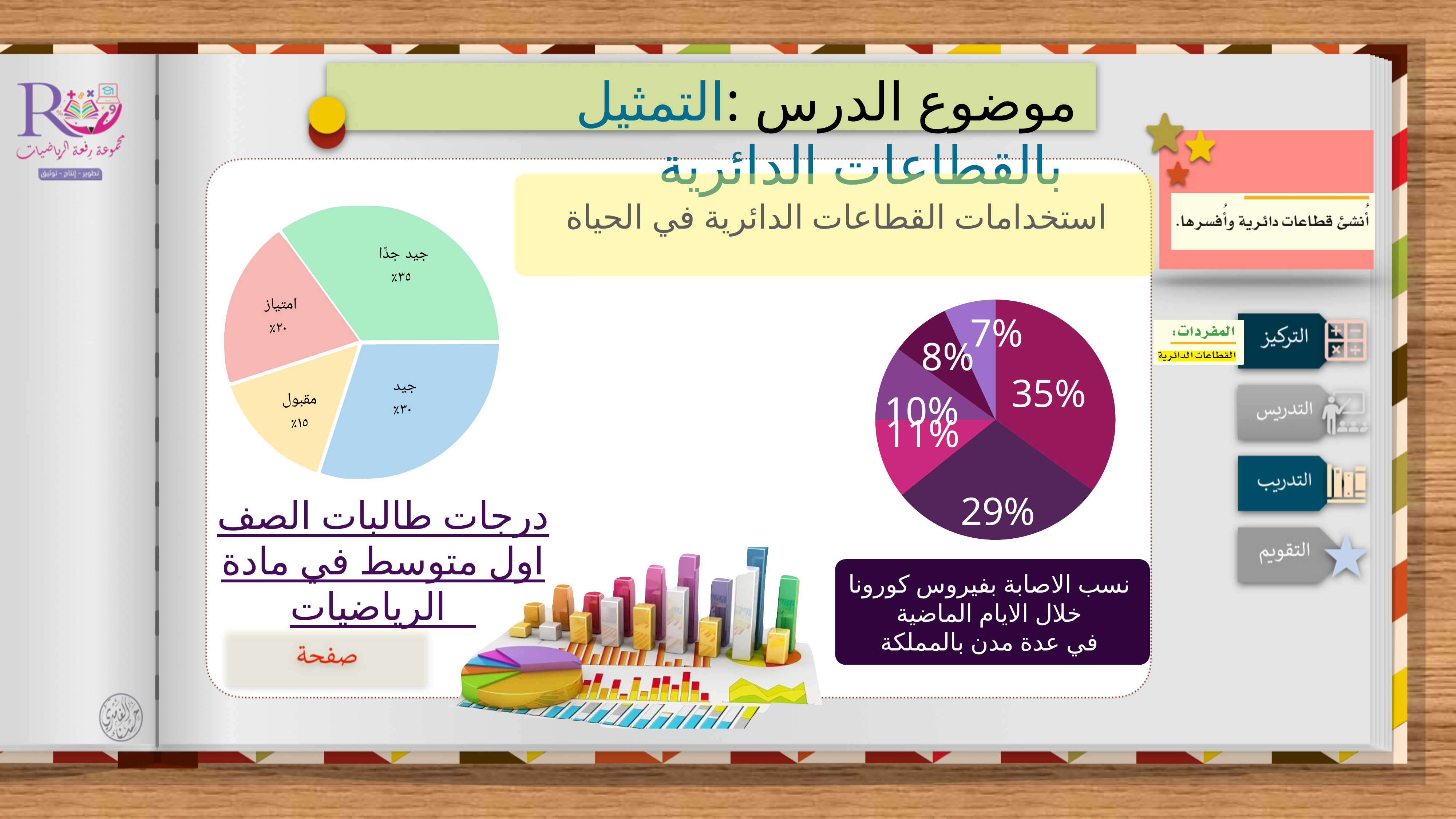
In the left pie chart (درجات طالبات الصف اول متوسط في مادة الرياضيات), what is the difference in percentage points between جيد جدًا and مقبول? 20 In the left pie chart (درجات طالبات الصف اول متوسط في مادة الرياضيات), what percentage is shown for امتياز? ٢٠٪ In the left pie chart (درجات طالبات الصف اول متوسط في مادة الرياضيات), how many slices does the pie have? 4 In the left pie chart (درجات طالبات الصف اول متوسط في مادة الرياضيات), which category has the largest slice? جيد جدًا What kind of chart is the right chart (نسب الاصابة بفيروس كورونا)? Pie chart In the right pie chart (نسب الاصابة بفيروس كورونا), how many slices does the pie have? 6 In the right pie chart (نسب الاصابة بفيروس كورونا), what is the smallest percentage shown? 7% In the left pie chart (درجات طالبات الصف اول متوسط في مادة الرياضيات), which category has the smallest slice? مقبول In the left pie chart (درجات طالبات الصف اول متوسط في مادة الرياضيات), which is larger, جيد or امتياز? جيد In the left pie chart (درجات طالبات الصف اول متوسط في مادة الرياضيات), what percentage is shown for مقبول? ١٥٪ In the left pie chart (درجات طالبات الصف اول متوسط في مادة الرياضيات), what percentage is shown for جيد جدًا? ٣٥٪ In the right pie chart (نسب الاصابة بفيروس كورونا), what is the largest percentage shown? 35%